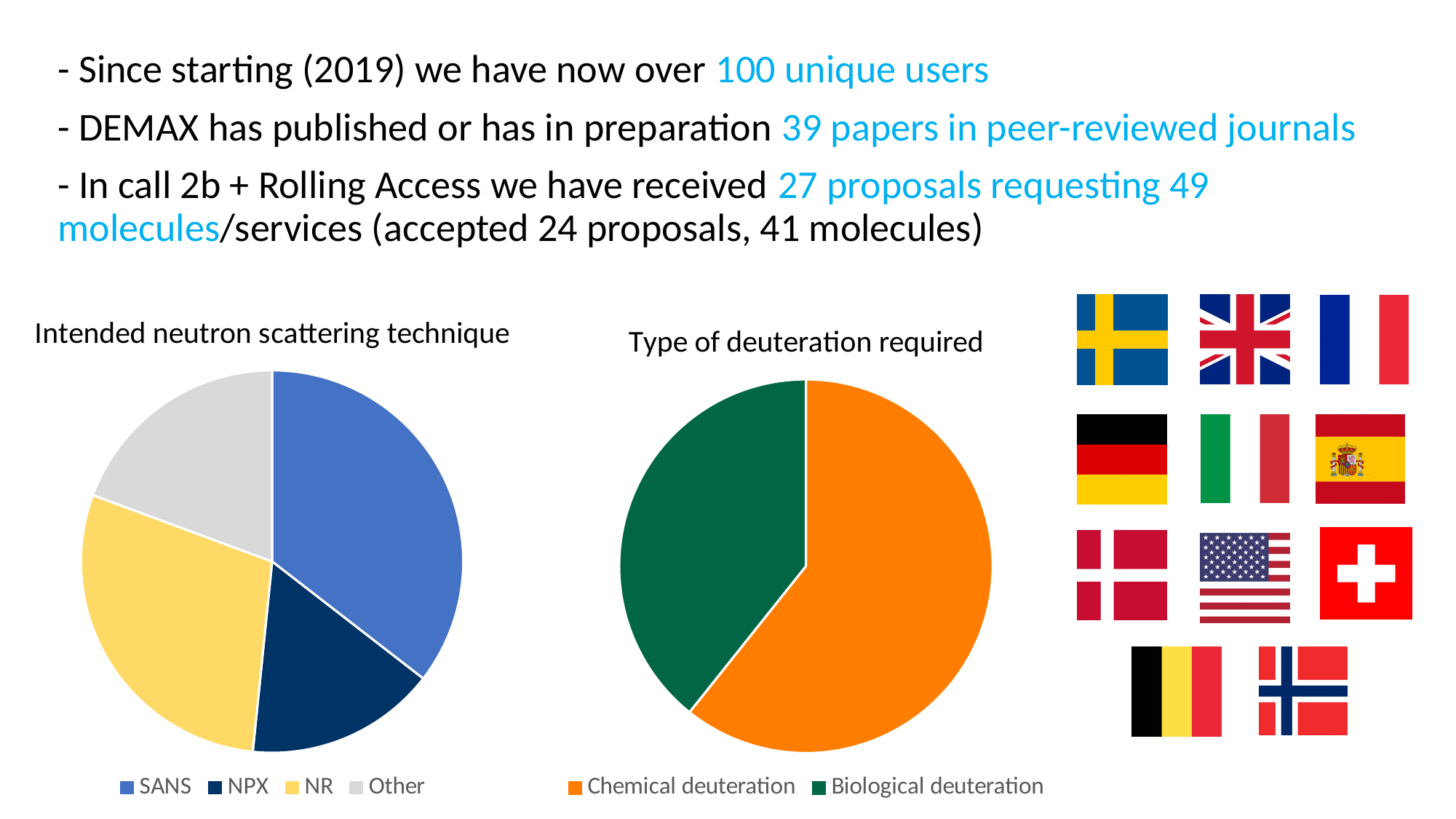
What kind of chart is the 'Type of deuteration required' chart? pie chart What kind of chart is the 'Intended neutron scattering technique' chart? pie chart In the 'Intended neutron scattering technique' chart, which category is shown in yellow? NR In the 'Intended neutron scattering technique' chart, how many categories does the legend list? 4 In the 'Type of deuteration required' chart, how many categories does the legend list? 2 In the 'Type of deuteration required' chart, what colour is the Biological deuteration slice? green In the 'Intended neutron scattering technique' chart, which slice is larger, NR or Other? NR In the 'Type of deuteration required' chart, which type of deuteration has the larger slice? Chemical deuteration How many pie charts are shown on the slide? 2 In the 'Type of deuteration required' chart, which type of deuteration has the smaller slice? Biological deuteration In the 'Intended neutron scattering technique' chart, which technique has the largest slice? SANS In the 'Intended neutron scattering technique' chart, which slice is larger, SANS or NPX? SANS